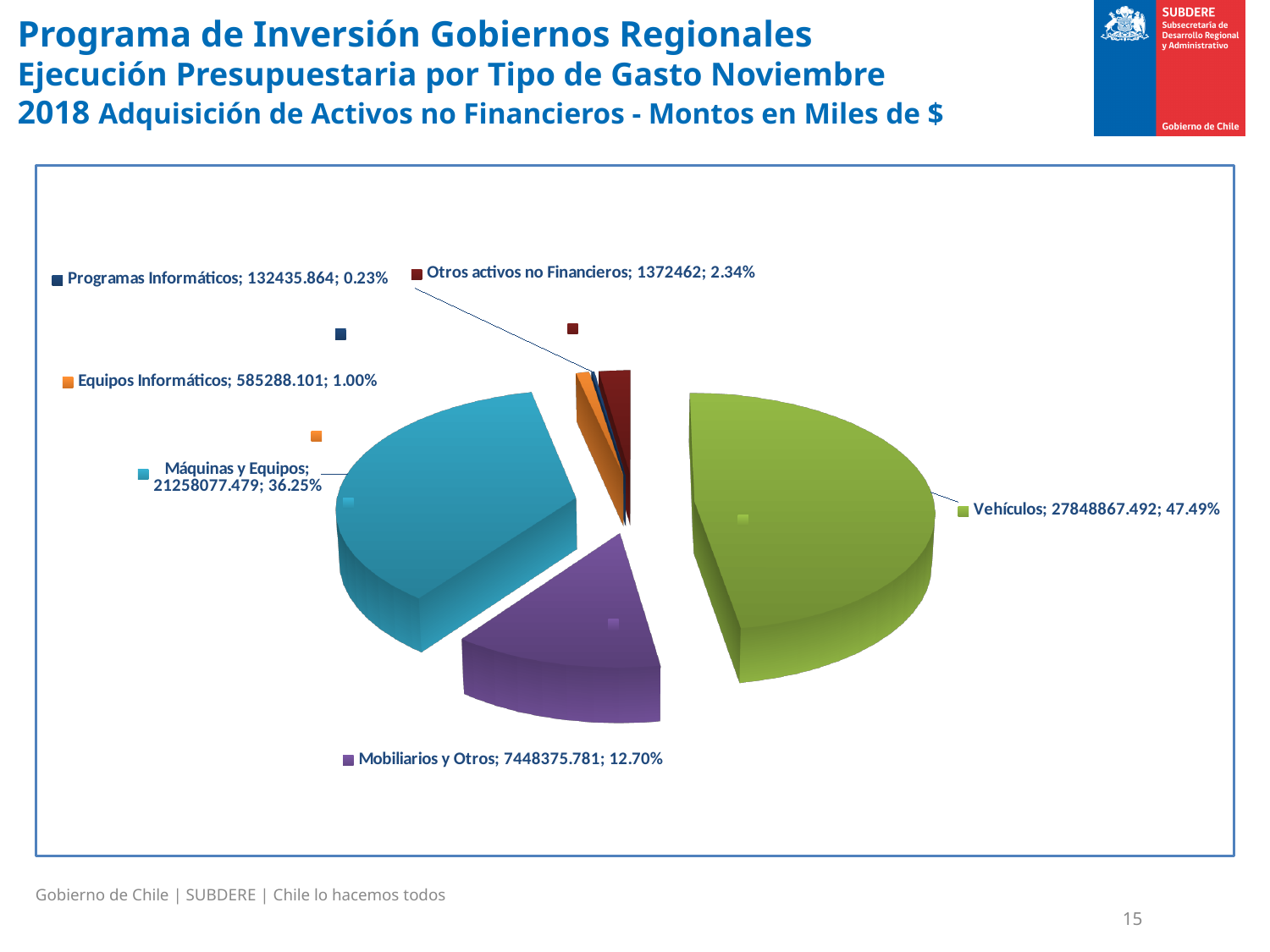
What is the value for Programas Informáticos? 132435.864 Which category has the smallest share of the pie? Programas Informáticos What is the value for Vehículos? 27848867.492 What kind of chart is shown on the slide? Pie chart Which category has the largest share of the pie? Vehículos Which is larger, Equipos Informáticos or Otros activos no Financieros? Otros activos no Financieros What percentage share does Otros activos no Financieros have? 2.34% What is the value for Mobiliarios y Otros? 7448375.781 What percentage share does Máquinas y Equipos have? 36.25% What is the difference in percentage share between Vehículos and Máquinas y Equipos? 11.24% What colour is the Vehículos slice? Green How many categories (slices) does the pie chart show? 6